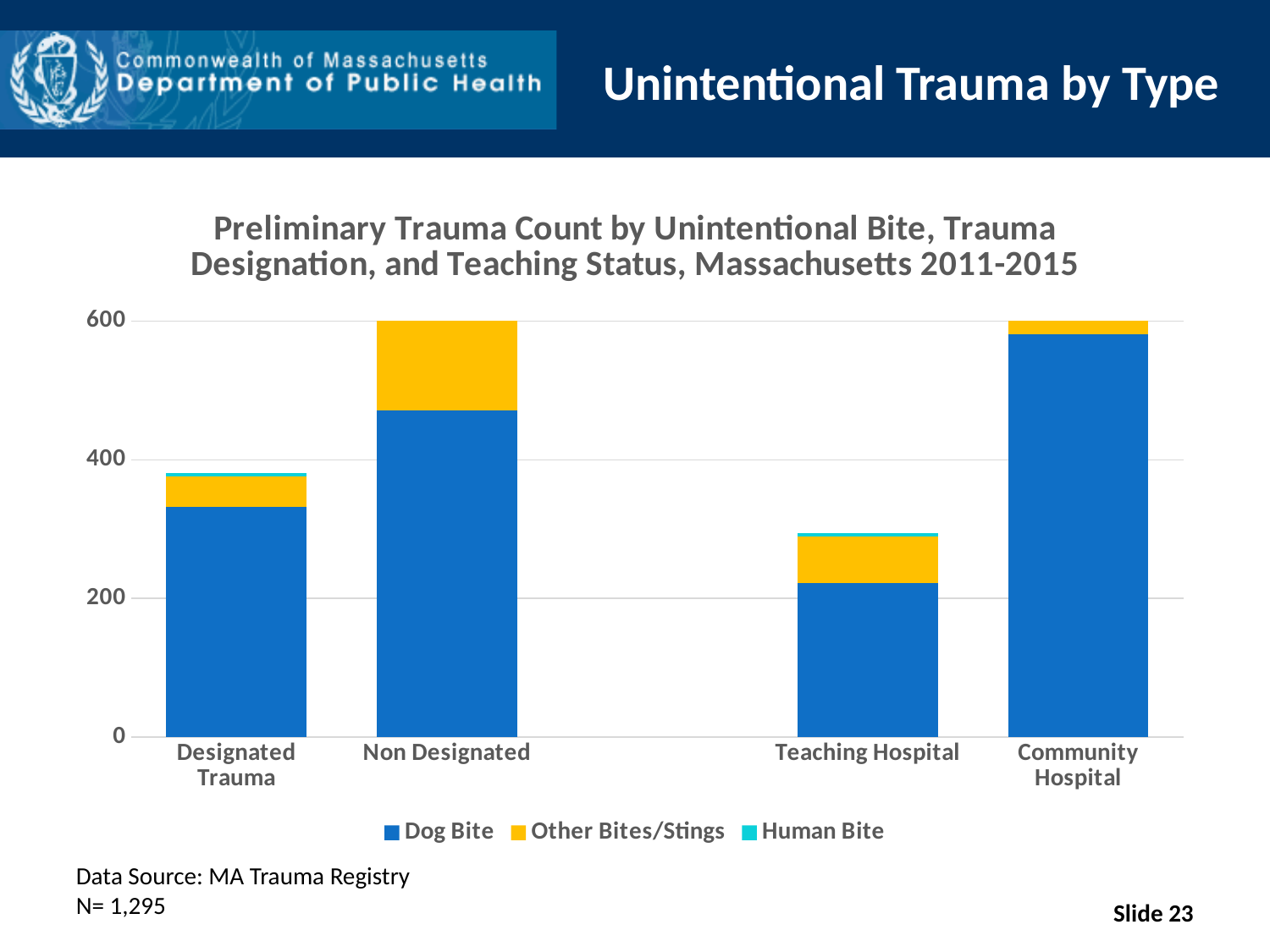
Which has the larger total stacked bar, Designated Trauma or Teaching Hospital? Designated Trauma Is the Dog Bite value for Community Hospital greater or less than 400? greater Which has the larger total stacked bar, Non Designated or Designated Trauma? Non Designated Which series is shown in yellow in the chart's legend? Other Bites/Stings Which category has the lowest total stacked bar? Teaching Hospital Is the total stacked bar for Designated Trauma greater or less than 400? less Is the Dog Bite value for Designated Trauma greater or less than 400? less How many series does the chart's legend list? 3 What kind of chart is shown on the slide? Bar chart How many categories are shown on the x axis of the chart? 4